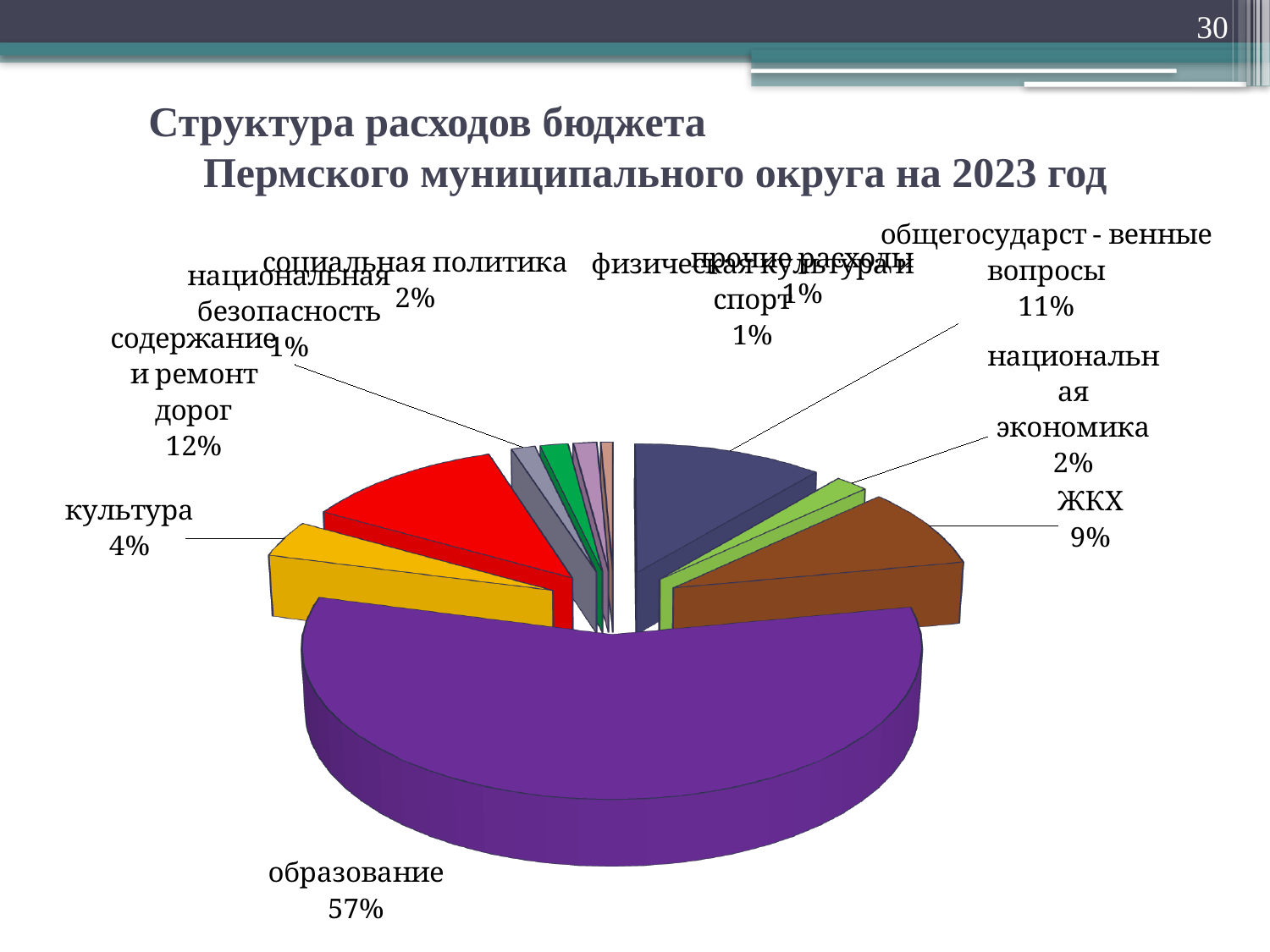
What is the difference between the share for ЖКХ and the share for культура? 5% What share of the budget expenditure goes to образование? 57% What share of the budget expenditure goes to общегосударственные вопросы? 11% What is the title of the chart on the slide? Структура расходов бюджета Пермского муниципального округа на 2023 год What share of the budget expenditure goes to национальная экономика? 2% Which category has the largest share of the budget expenditure? образование What share of the budget expenditure goes to культура? 4% What share of the budget expenditure goes to ЖКХ? 9% Which is larger, the share for содержание и ремонт дорог or the share for ЖКХ? содержание и ремонт дорог What is the difference between the share for образование and the share for общегосударственные вопросы? 46% What kind of chart is shown on the slide? pie chart What share of the budget expenditure goes to содержание и ремонт дорог? 12%